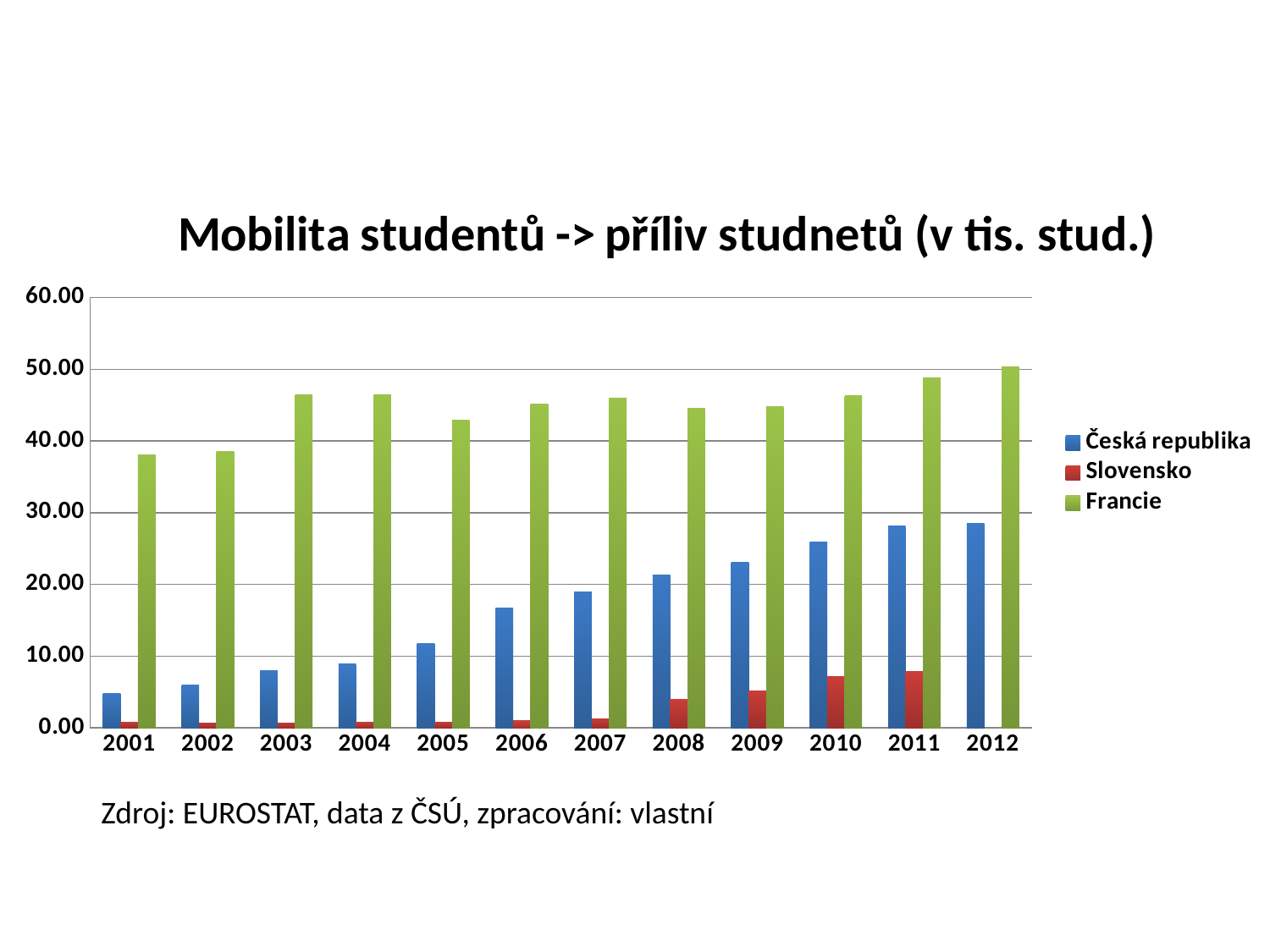
Is the value for Francie in 2012 greater or less than 40? greater What kind of chart is shown on the slide? bar chart How many series does the legend list? 3 In 2011, which is larger: Česká republika or Slovensko? Česká republika Do the values for Česká republika rise or fall from 2001 to 2012? rise How many years are shown on the x axis? 12 In which year is the value for Francie highest? 2012 Is the value for Francie in 2001 greater or less than 40? less Is the value for Česká republika in 2011 greater or less than 20? greater Which series has the highest value in 2012? Francie